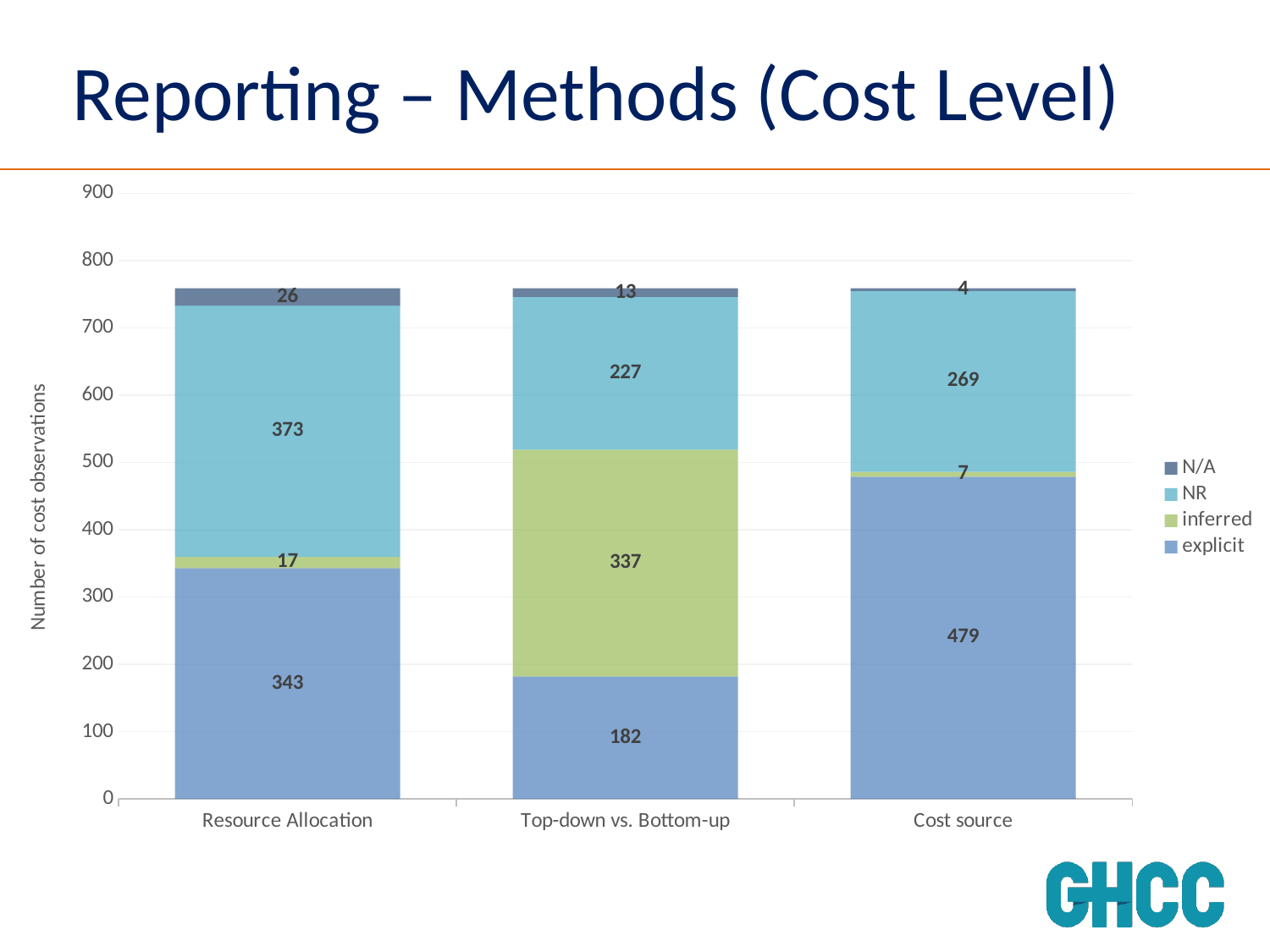
Which category has the lowest inferred value? Cost source What is the inferred value for Top-down vs. Bottom-up? 337 How many series does the legend list? 4 Which category has the highest explicit value? Cost source How many categories are shown on the x axis? 3 What is the total of the stacked bar for Cost source? 759 What is the NR value for Cost source? 269 Which is larger, the explicit value for Top-down vs. Bottom-up or the explicit value for Resource Allocation? Resource Allocation What is the difference between the NR values for Resource Allocation and Top-down vs. Bottom-up? 146 What is the explicit value for Resource Allocation? 343 What is the N/A value for Resource Allocation? 26 What kind of chart is shown on the slide? Stacked bar chart